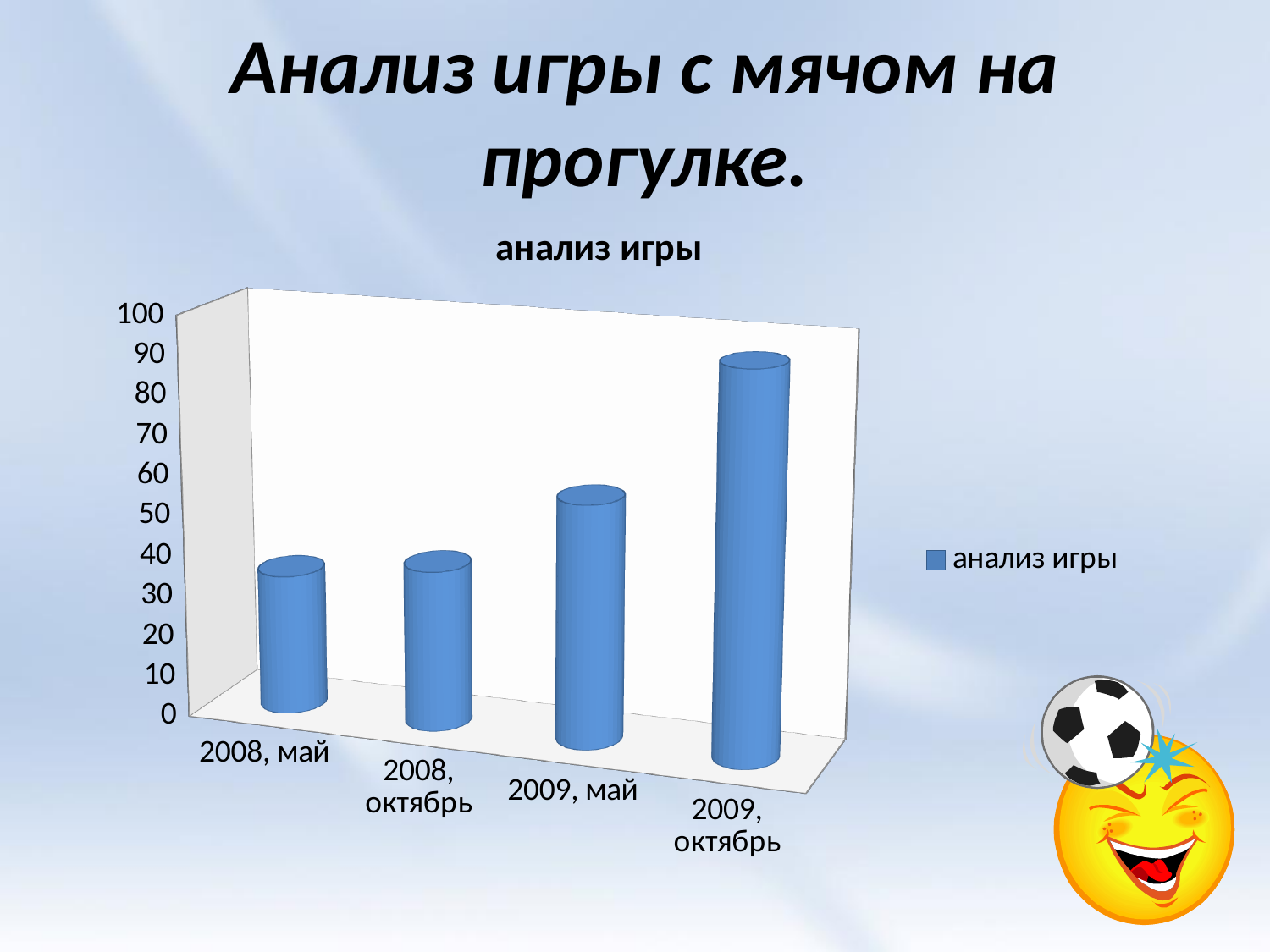
Which is larger, the value for 2009, октябрь or the value for 2009, май? 2009, октябрь What is the title of the chart? анализ игры What type of chart is shown on the slide? bar chart How many categories are shown on the x axis of the chart? 4 Which is larger, the value for 2009, май or the value for 2008, май? 2009, май Is the value for 2008, май greater or less than 50? less Which category has the highest value in the chart? 2009, октябрь What is the name of the series shown in the chart legend? анализ игры How many series does the chart legend list? 1 Is the value for 2009, май greater or less than 40? greater Is the value for 2009, октябрь greater or less than 70? greater Do the values rise or fall from 2008, май to 2009, октябрь? rise